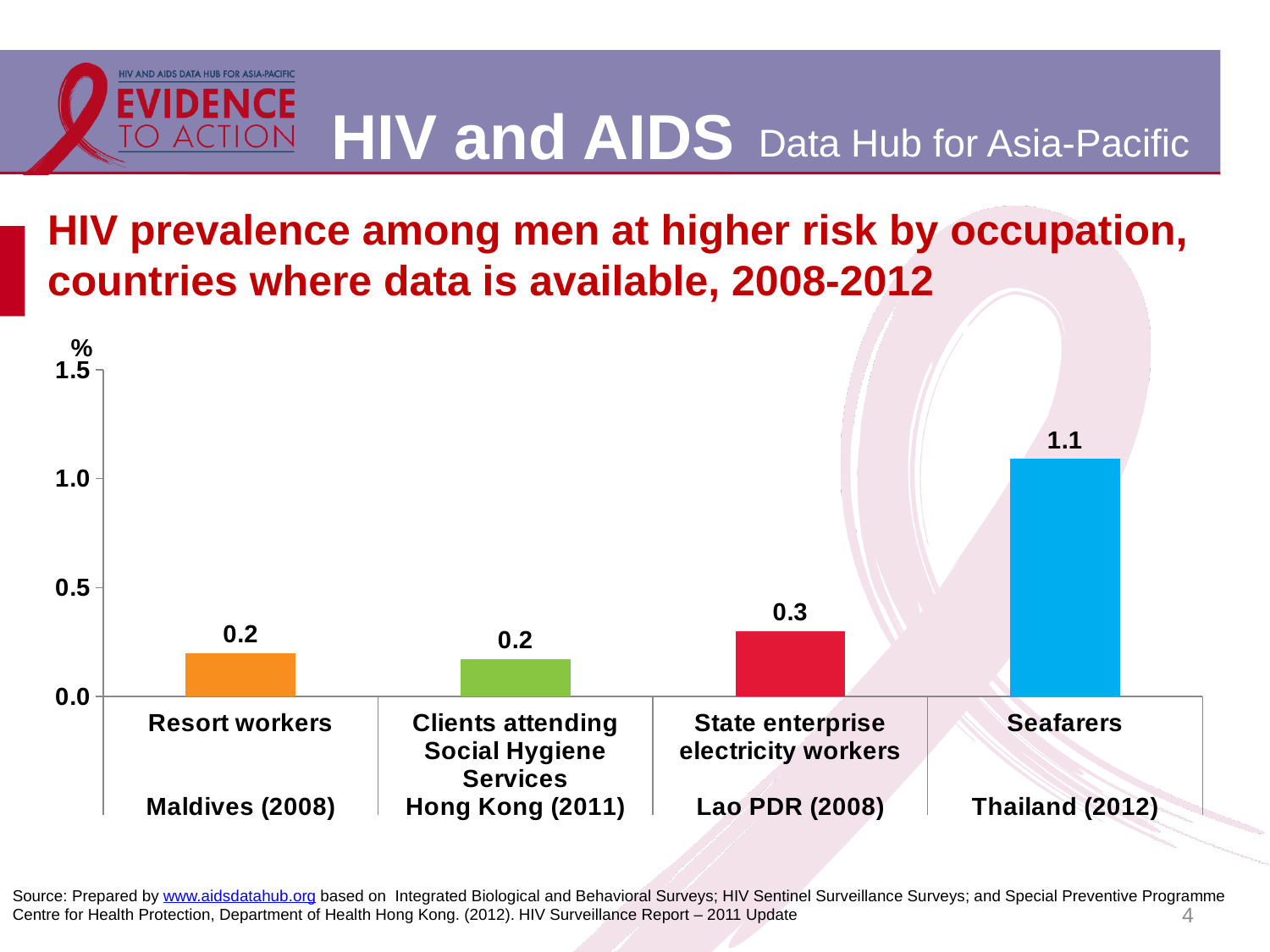
What is the difference in HIV prevalence between seafarers in Thailand and state enterprise electricity workers in Lao PDR? 0.8 What is the HIV prevalence among resort workers in the Maldives (2008)? 0.2 Is the HIV prevalence for seafarers in Thailand greater or less than 1.0? greater Which is larger: the HIV prevalence for state enterprise electricity workers in Lao PDR or for resort workers in the Maldives? State enterprise electricity workers in Lao PDR Which occupation group has the highest HIV prevalence on the chart? Seafarers What is the HIV prevalence among clients attending Social Hygiene Services in Hong Kong (2011)? 0.2 How many occupation groups are shown on the chart? 4 What is the HIV prevalence among state enterprise electricity workers in Lao PDR (2008)? 0.3 What is the HIV prevalence among seafarers in Thailand (2012)? 1.1 What type of chart is shown on the slide? Bar chart Is the HIV prevalence for state enterprise electricity workers in Lao PDR greater or less than 0.5? less What unit is shown on the vertical axis of the chart? %